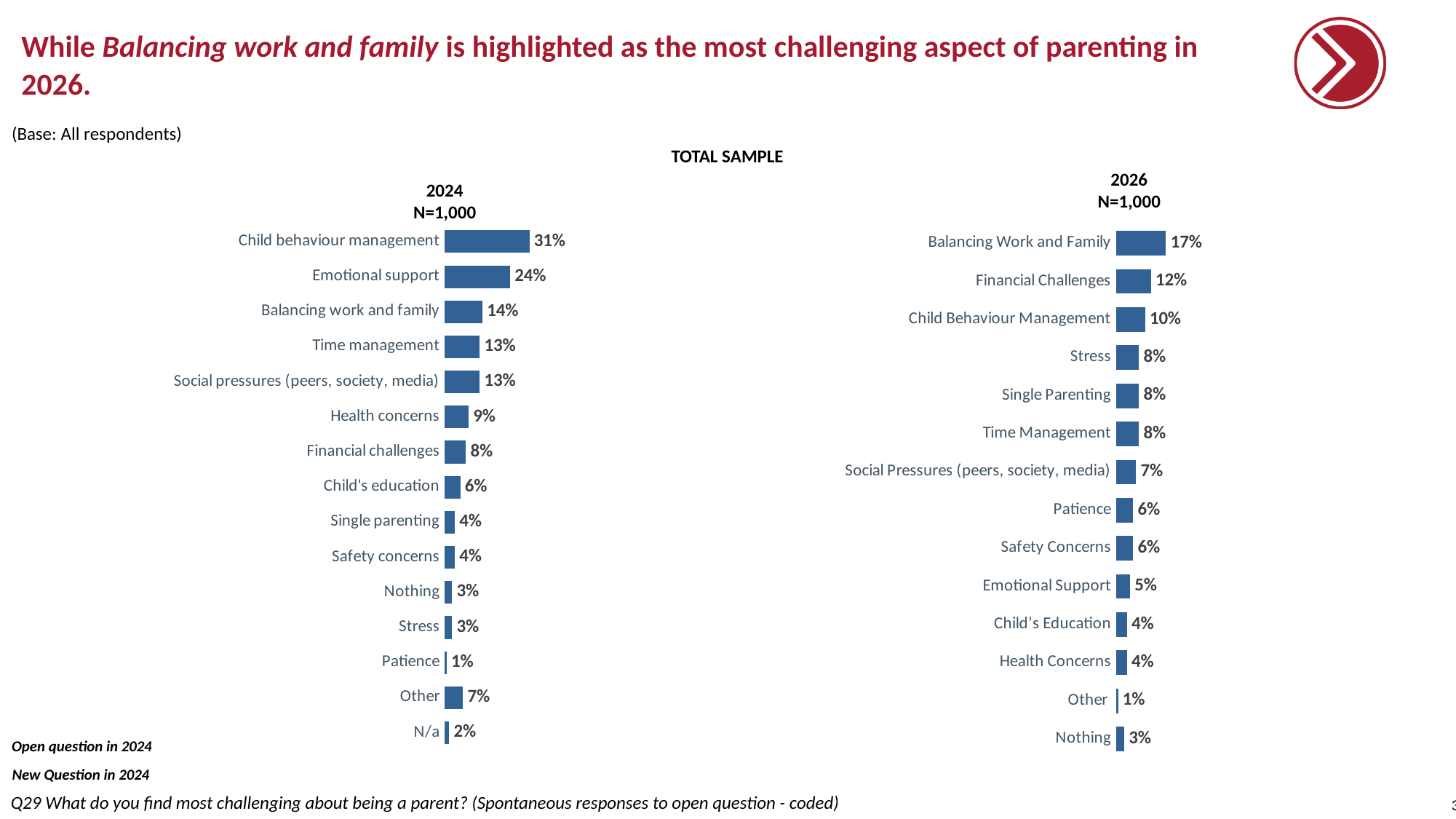
In the 2024 chart, which is larger: Health concerns or Financial challenges? Health concerns In the 2026 chart, what percentage is shown for Financial Challenges? 12% In the 2026 chart, what percentage is shown for Balancing Work and Family? 17% In the 2024 chart, which category has the highest value? Child behaviour management In the 2024 chart, what is the difference between Child behaviour management and Emotional support? 7% In the 2024 chart, which category has the lowest value? Patience What is the sample size (N) shown for the 2026 chart? N=1,000 In the 2026 chart, which category has the lowest value? Other How many categories are shown in the 2026 chart? 14 In the 2026 chart, what is the difference between Balancing Work and Family and Child Behaviour Management? 7% What type of chart is used for the 2024 data? Bar chart In the 2024 chart, what percentage is shown for Child behaviour management? 31%